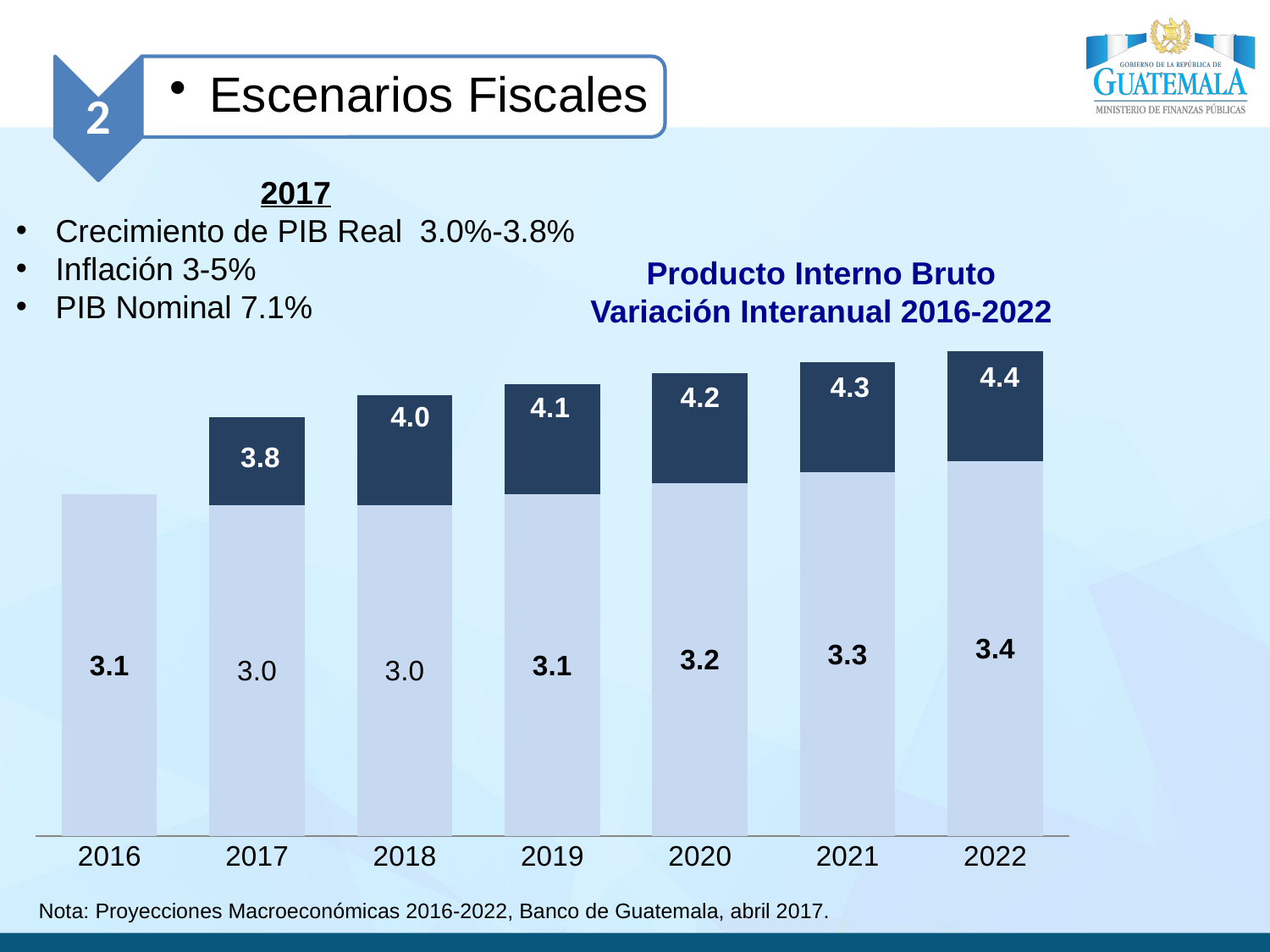
What is the value shown in the light blue segment for 2021? 3.3 Do the dark blue segment values rise or fall from 2017 to 2022? Rise What is the value shown in the light blue segment for 2018? 3.0 What is the value shown in the light blue segment for 2016? 3.1 Which year has the highest value in the dark blue segment? 2022 What is the difference between the dark blue segment values for 2022 and 2017? 0.6 Which is larger, the light blue segment value for 2020 or for 2018? 2020 How many years are shown on the x axis of the chart? 7 What is the value shown in the dark blue segment for 2022? 4.4 What kind of chart is shown on the slide? Bar chart Which year has the lowest value in the dark blue segment? 2017 What is the value shown in the dark blue segment for 2017? 3.8